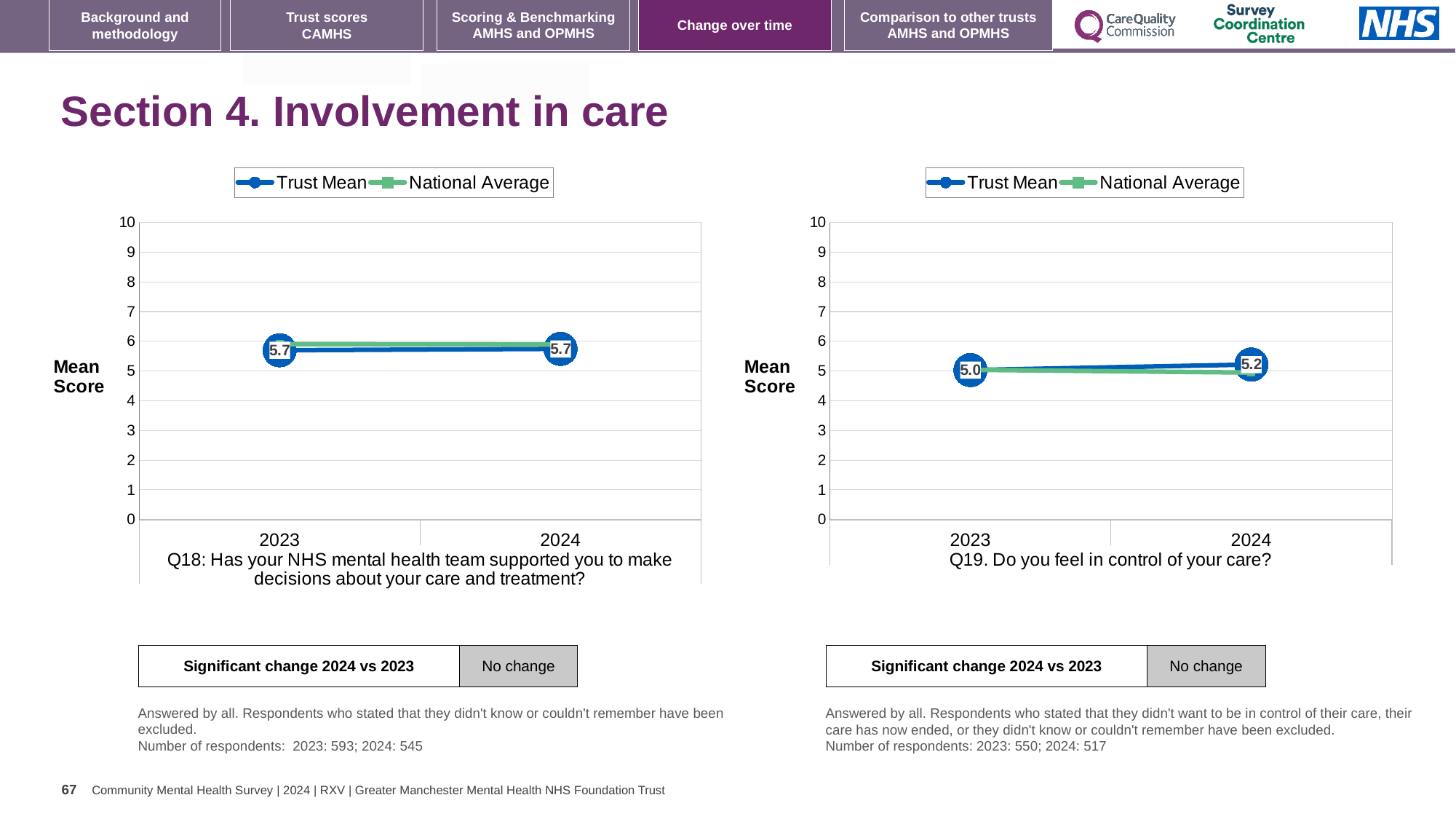
In the Q19 chart on the right, by how much did the Trust Mean change from 2023 to 2024? 0.2 In the Q18 chart on the left, what is the Trust Mean score for 2023? 5.7 What kind of chart is the Q18 chart on the left? line chart How many years are shown on the x axis of the Q18 chart on the left? 2 In the Q19 chart on the right, which year has the higher Trust Mean, 2023 or 2024? 2024 In the Q19 chart on the right, does the Trust Mean rise or fall from 2023 to 2024? rise In the Q18 chart on the left, what is the Trust Mean score for 2024? 5.7 In the Q19 chart on the right, what is the Trust Mean score for 2024? 5.2 How many series does the legend of the Q19 chart on the right list? 2 What does the 'Significant change 2024 vs 2023' box below the Q19 chart on the right say? No change In the Q19 chart on the right, what is the Trust Mean score for 2023? 5.0 In the Q18 chart on the left, is the National Average for 2024 greater or less than 5? greater